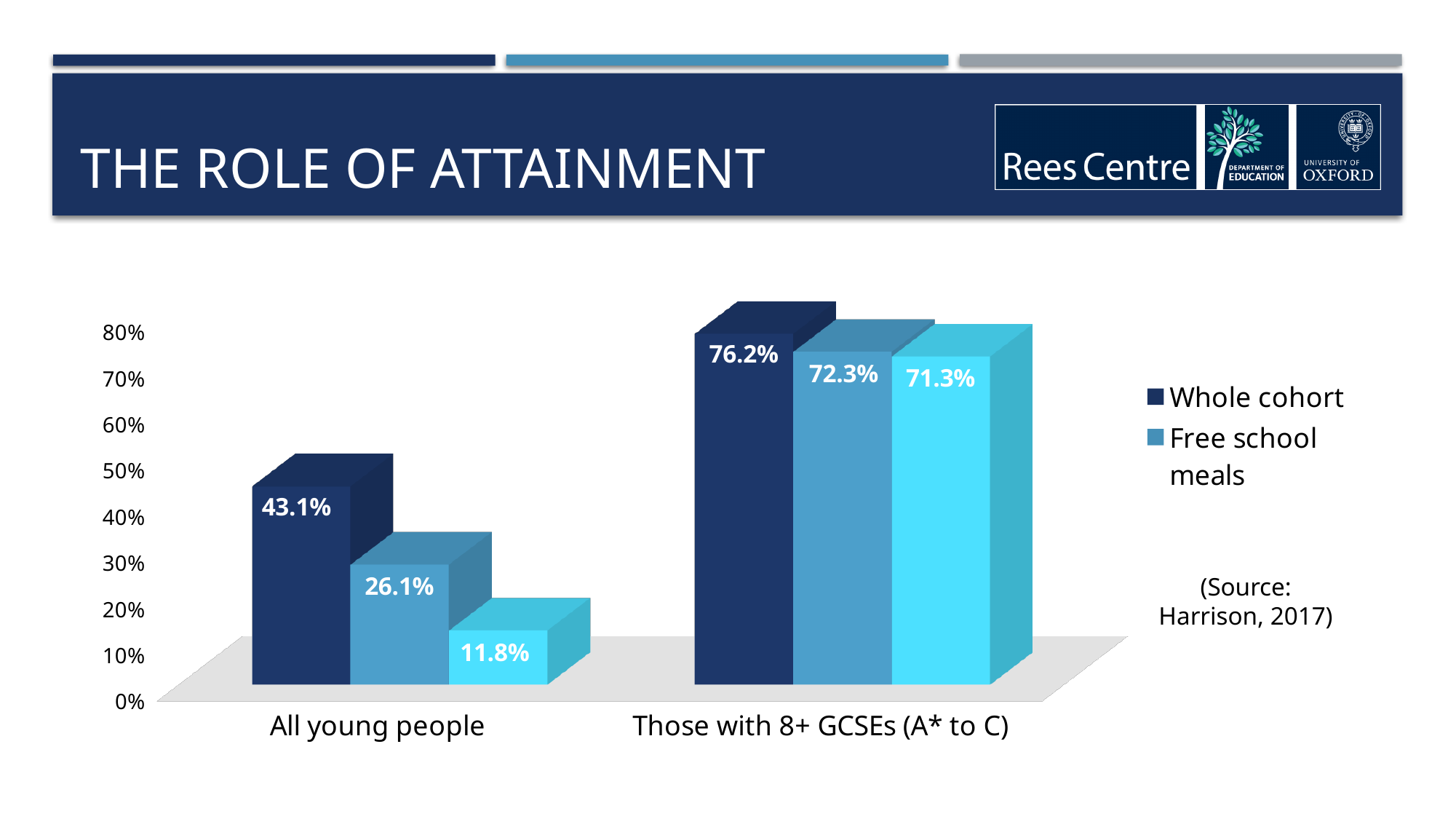
What is the difference between the Whole cohort values for Those with 8+ GCSEs (A* to C) and All young people? 33.1% How many series does the legend list? 2 Which category has the highest Whole cohort value? Those with 8+ GCSEs (A* to C) What is the value for Whole cohort in the All young people category? 43.1% What is the difference between the Whole cohort and Free school meals values in the All young people category? 17.0% What is the value for Free school meals in the All young people category? 26.1% How many categories are shown on the x axis? 2 Which is larger: the Whole cohort value or the Free school meals value for All young people? Whole cohort Is the Free school meals value for Those with 8+ GCSEs (A* to C) greater or less than 70%? greater What is the value for Free school meals in the Those with 8+ GCSEs (A* to C) category? 72.3% What is the value for Whole cohort in the Those with 8+ GCSEs (A* to C) category? 76.2% What kind of chart is shown on the slide? Bar chart